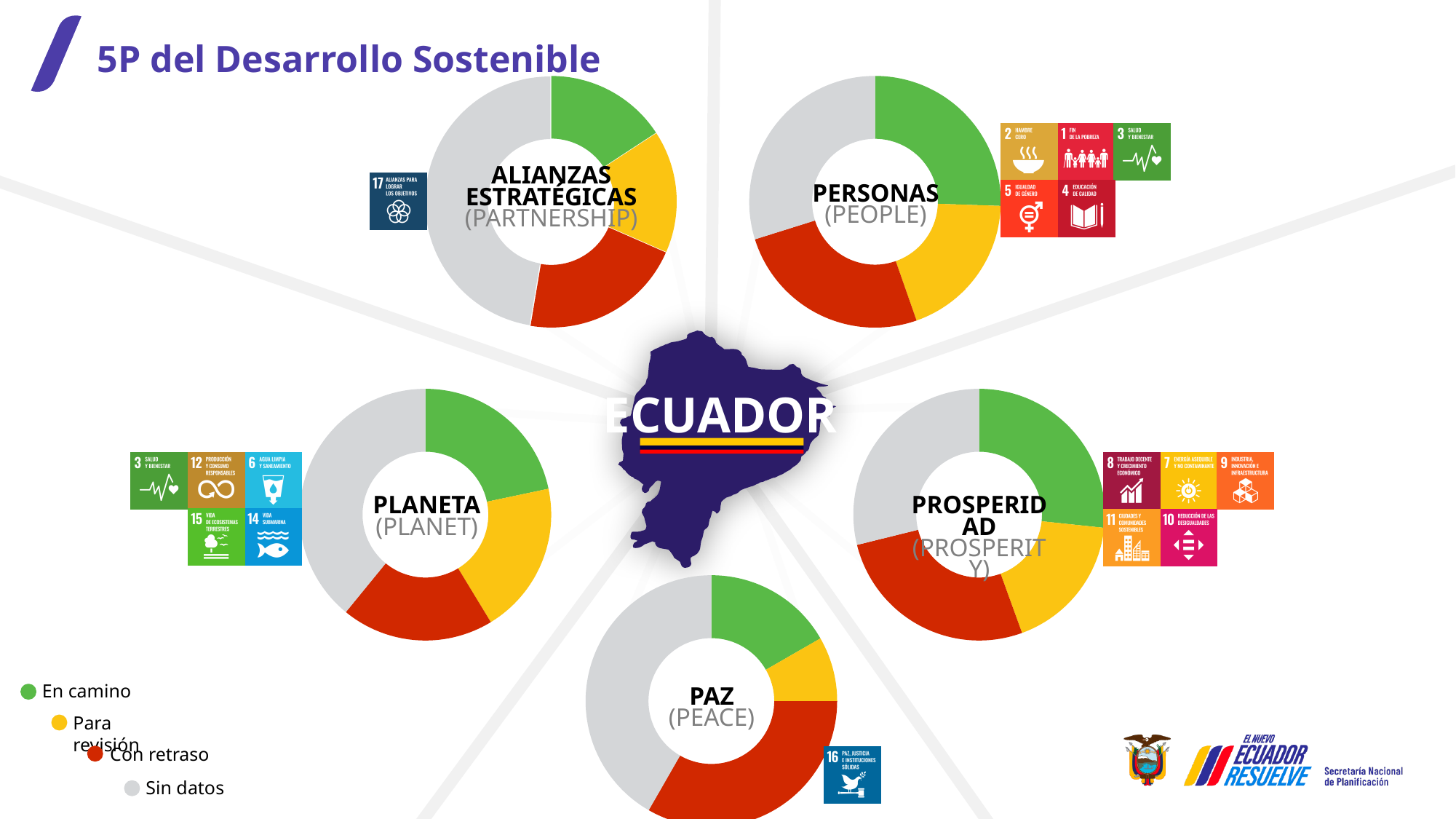
In the ALIANZAS ESTRATÉGICAS (PARTNERSHIP) chart, which legend category has the largest slice? Sin datos Which colour represents 'Sin datos' in the legend? grey In the PAZ (PEACE) chart, which legend category has the largest slice? Sin datos In the PROSPERIDAD (PROSPERITY) chart, which legend category has the smallest slice? Para revisión What is the title of the slide? 5P del Desarrollo Sostenible How many pie charts are shown on the slide? 5 In the PLANETA (PLANET) chart, which slice is larger: En camino or Para revisión? En camino In the PERSONAS (PEOPLE) chart, which slice is larger: En camino or Para revisión? En camino In the PROSPERIDAD (PROSPERITY) chart, which slice is larger: Con retraso or Para revisión? Con retraso In the PAZ (PEACE) chart, which legend category has the smallest slice? Para revisión How many categories does the legend list? 4 What kind of chart is used for each of the five categories on the slide? doughnut chart